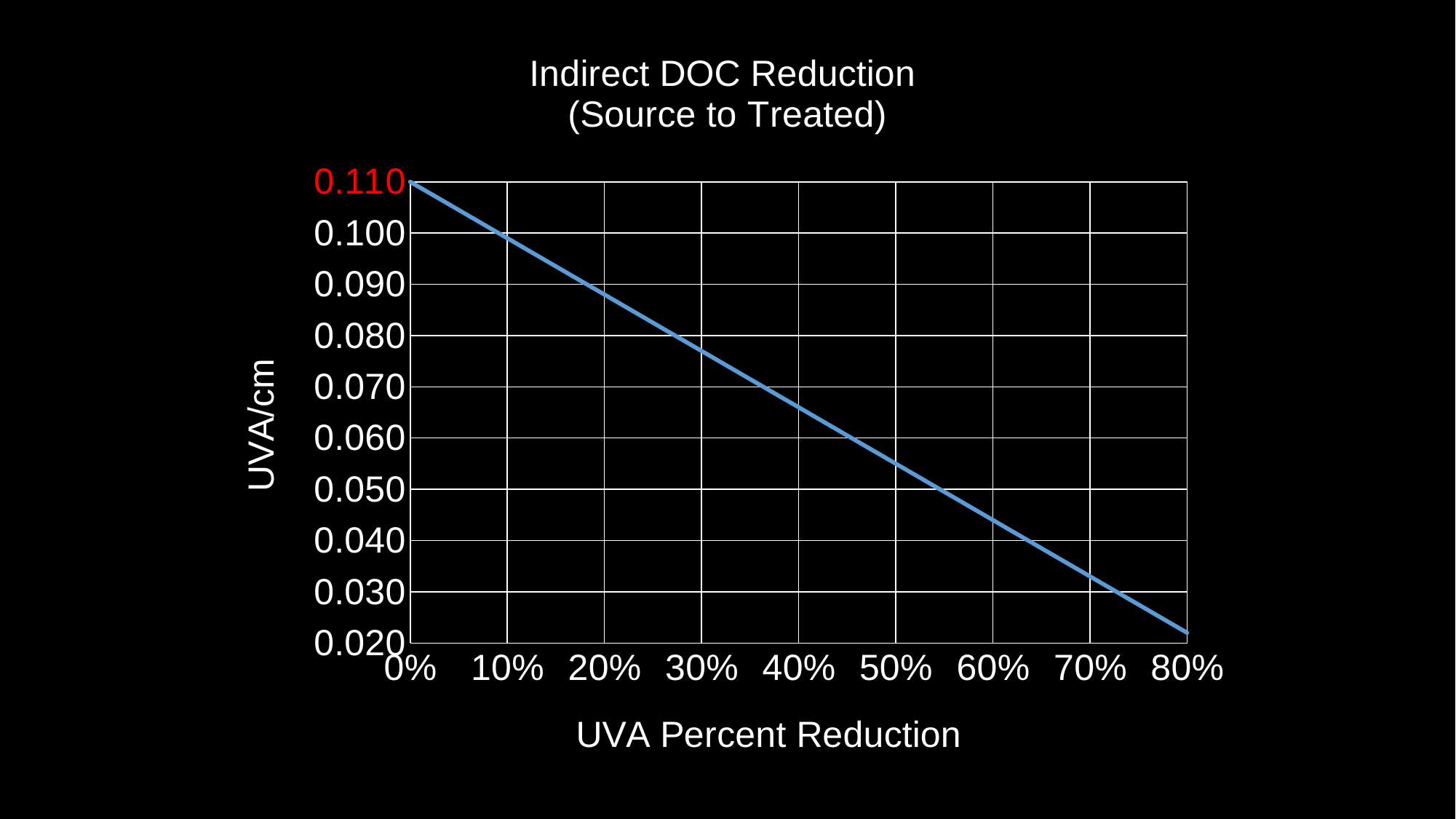
What is the label of the y axis? UVA/cm How many tick labels are shown on the x axis? 9 Does the UVA/cm value rise or fall as UVA Percent Reduction increases? fall What is the UVA/cm value at 0% UVA Percent Reduction? 0.110 Is the UVA/cm value at 80% UVA Percent Reduction greater or less than 0.030? less Is the UVA/cm value at 40% UVA Percent Reduction greater or less than 0.070? less What is the title of the chart? Indirect DOC Reduction (Source to Treated) Is the UVA/cm value at 60% UVA Percent Reduction greater or less than 0.040? greater Which UVA Percent Reduction value has the highest UVA/cm, 0% or 80%? 0% What kind of chart is shown on the slide? line chart